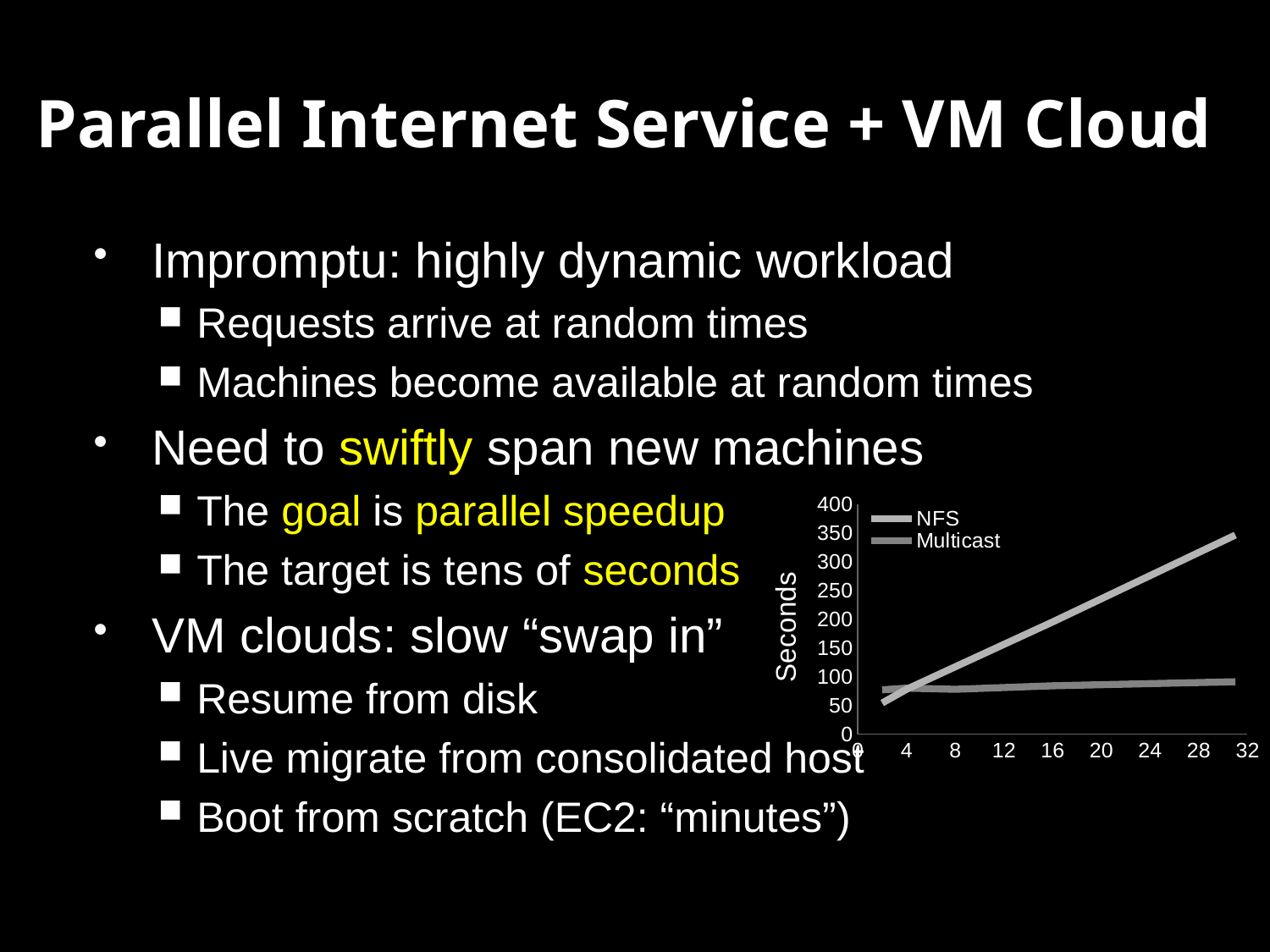
At x = 32, which series has the larger value, NFS or Multicast? NFS What are the two series named in the chart's legend? NFS and Multicast Is the NFS value at x = 24 greater or less than 250? greater How many series does the chart's legend list? 2 What is the label on the chart's vertical axis? Seconds Does the NFS line rise or fall as the x-axis value increases? rise Which series reaches the highest value on the chart? NFS Is the Multicast value at x = 16 greater or less than 100? less At x = 24, which series has the larger value, NFS or Multicast? NFS Is the NFS value at x = 32 greater or less than 300? greater What kind of chart is shown on the slide? line chart